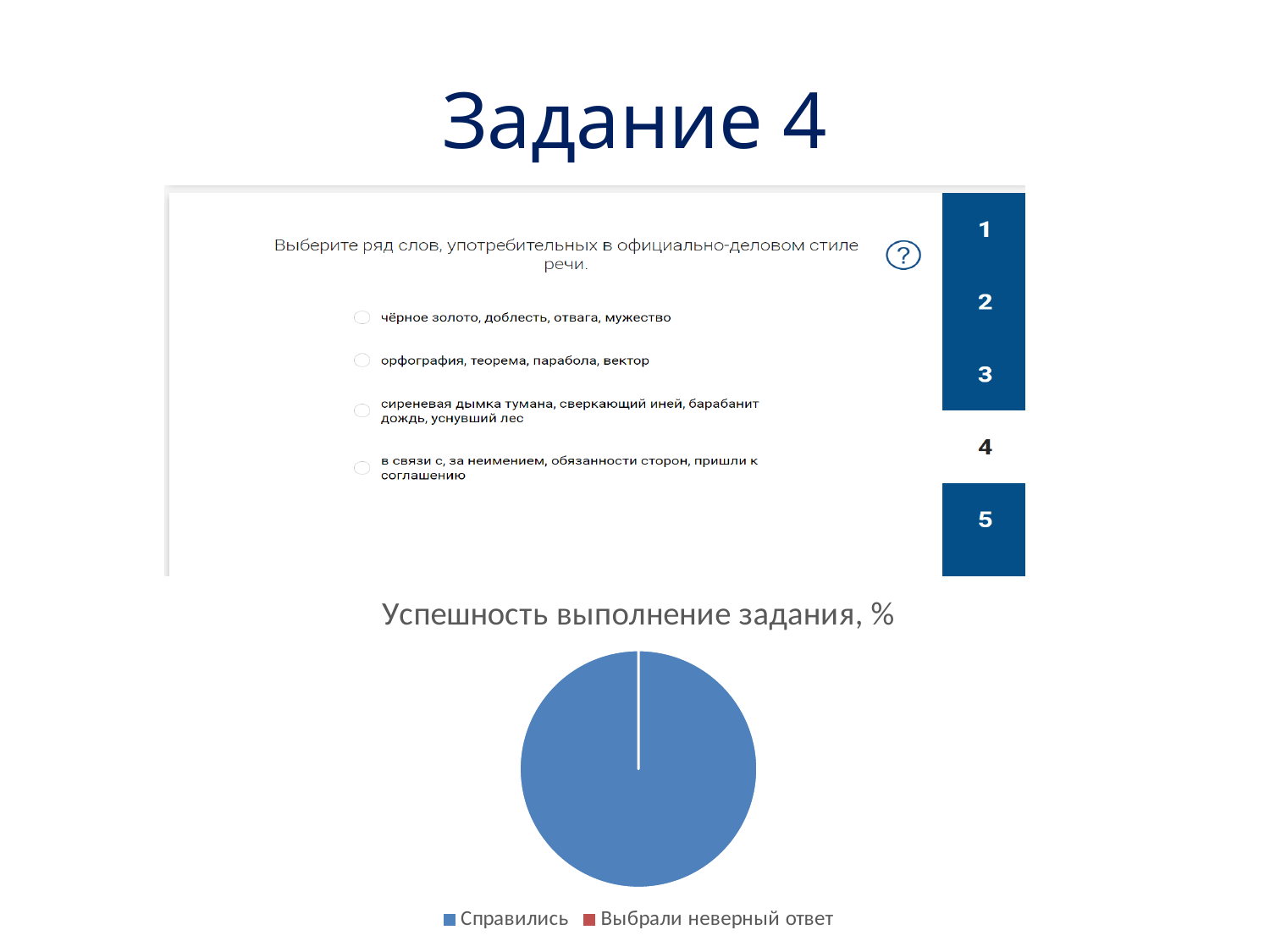
What kind of chart is shown under the heading "Успешность выполнение задания, %"? pie chart Which category has the smallest slice in the pie chart? Выбрали неверный ответ Which category has the largest slice in the pie chart? Справились What is the title of the chart on the slide? Успешность выполнение задания, % How many entries does the legend of the pie chart list? 2 What colour represents Справились in the pie chart? blue In the pie chart, which is larger: Справились or Выбрали неверный ответ? Справились How many categories are listed in the legend of the pie chart? 2